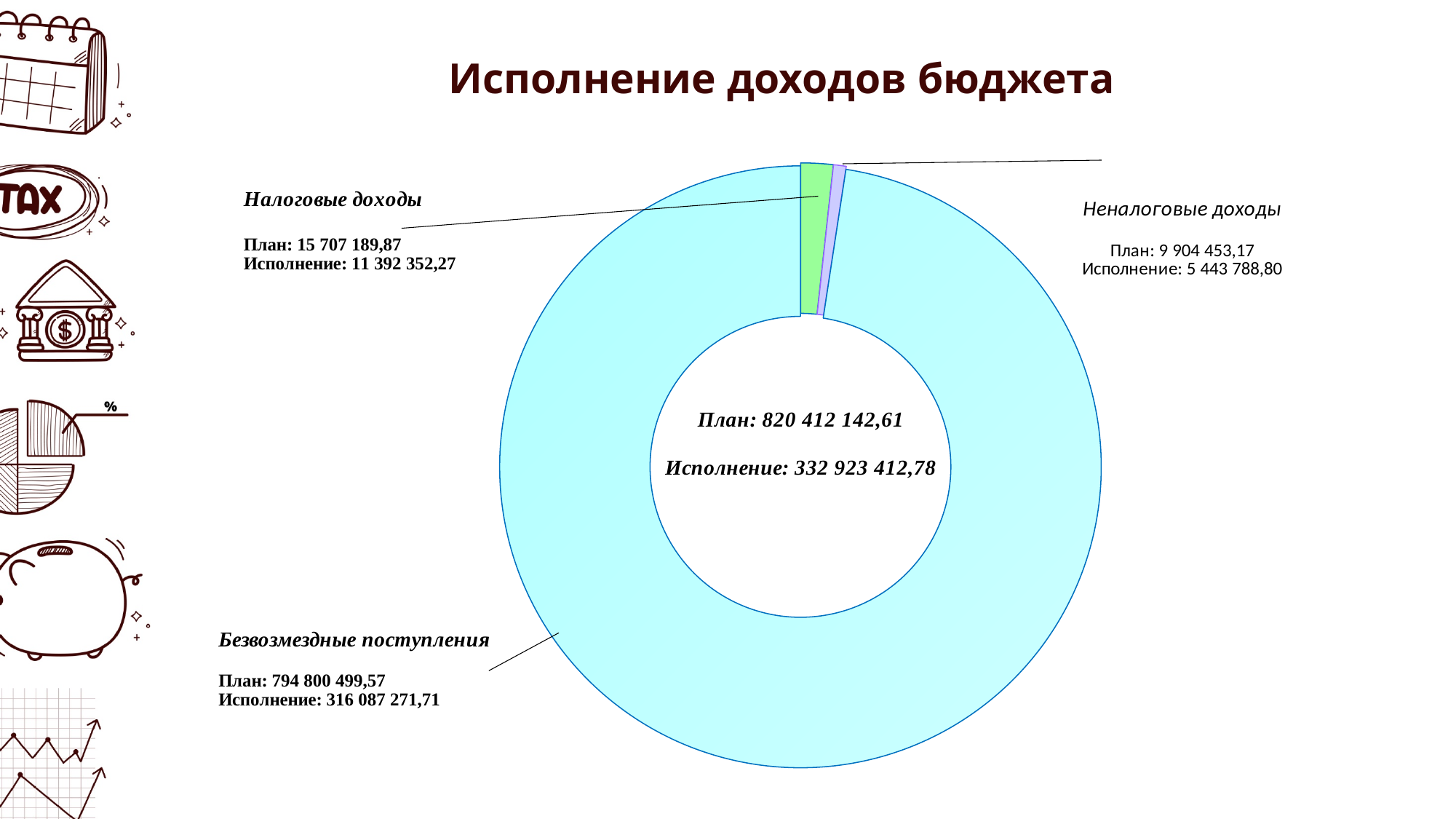
What is the План value for Налоговые доходы? 15 707 189,87 What is the difference between План and Исполнение for Налоговые доходы? 4 314 837,60 What is the Исполнение value for Безвозмездные поступления? 316 087 271,71 How many categories does the donut chart show? 3 What is the Исполнение value for Налоговые доходы? 11 392 352,27 Which category takes up the smallest share of the donut chart? Неналоговые доходы What total План value is shown in the centre of the donut chart? 820 412 142,61 What is the План value for Неналоговые доходы? 9 904 453,17 Which has the larger План value: Налоговые доходы or Неналоговые доходы? Налоговые доходы What total Исполнение value is shown in the centre of the donut chart? 332 923 412,78 Which category takes up the largest share of the donut chart? Безвозмездные поступления What kind of chart is shown on the slide? Donut (pie) chart